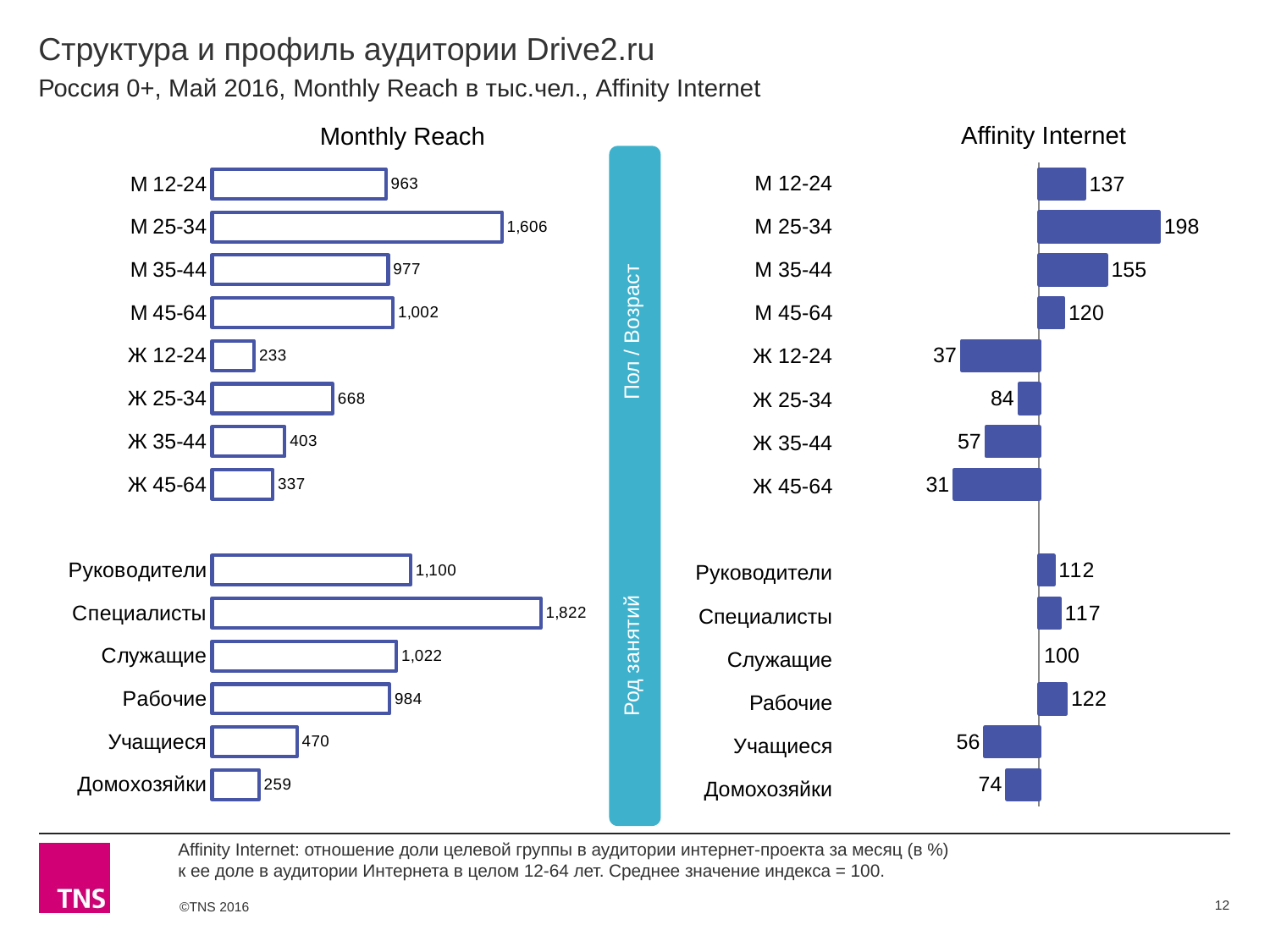
In the Monthly Reach chart, what is the value for М 25-34? 1,606 In the Affinity Internet chart, which is larger: Рабочие or Специалисты? Рабочие What type of chart is the Affinity Internet chart? Bar chart In the Affinity Internet chart, which category has the lowest value? Ж 45-64 In the Monthly Reach chart, what is the difference between Руководители and Учащиеся? 630 In the Monthly Reach chart, which is larger: Ж 25-34 or Ж 35-44? Ж 25-34 In the Affinity Internet chart, which category has the highest value? М 25-34 In the Monthly Reach chart, which category has the lowest value? Ж 12-24 In the Affinity Internet chart, what is the value for Ж 45-64? 31 In the Monthly Reach chart, which category has the highest value? Специалисты In the Affinity Internet chart, what is the difference between М 35-44 and М 45-64? 35 How many categories are plotted in the Monthly Reach chart? 14